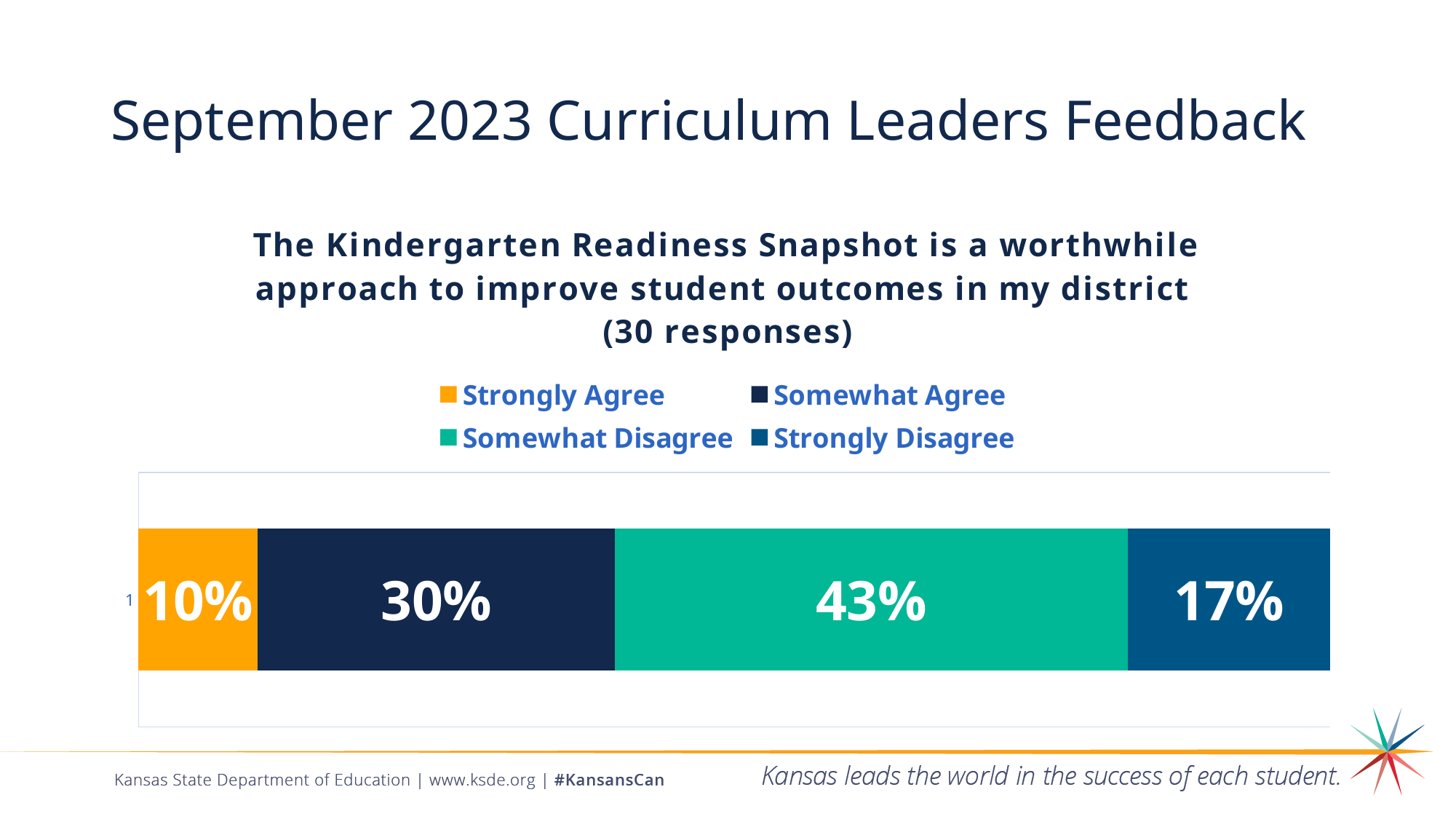
How many series does the legend list? 4 How many responses does the chart title say were collected? 30 What is the difference in percentage points between Somewhat Disagree and Somewhat Agree? 13 Which is larger, the share for Somewhat Agree or the share for Strongly Disagree? Somewhat Agree Which response category has the largest share? Somewhat Disagree What percentage of respondents selected Somewhat Agree? 30% What kind of chart is shown on the slide? Stacked bar chart What is the total of the stacked bar? 100% What percentage of respondents selected Somewhat Disagree? 43% What percentage of respondents selected Strongly Agree? 10% What percentage of respondents selected Strongly Disagree? 17% Which response category has the smallest share? Strongly Agree